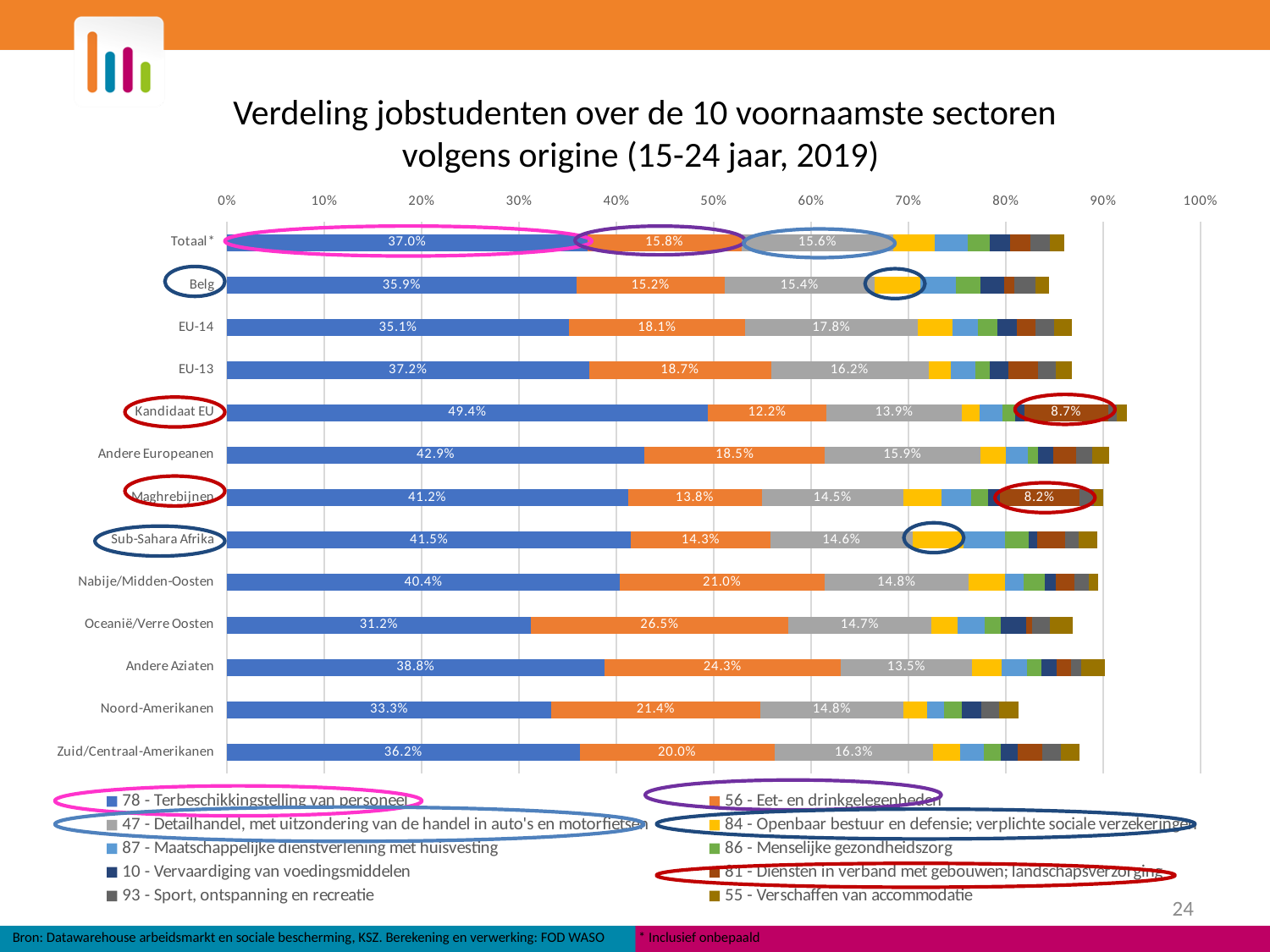
Which origin group has the highest share for '78 - Terbeschikkingstelling van personeel'? Kandidaat EU Which origin group has the highest share for '56 - Eet- en drinkgelegenheden'? Oceanië/Verre Oosten How many sectors (series) does the legend list? 10 Which has a larger share for '47 - Detailhandel, met uitzondering van de handel in auto's en motorfietsen': EU-14 or EU-13? EU-14 What is the value for '81 - Diensten in verband met gebouwen; landschapsverzorging' for Kandidaat EU? 8.7% Which origin group has the lowest share for '78 - Terbeschikkingstelling van personeel'? Oceanië/Verre Oosten What is the value for '56 - Eet- en drinkgelegenheden' in the Belg bar? 15.2% How many percentage points higher is the '78 - Terbeschikkingstelling van personeel' share for Kandidaat EU than for Totaal*? 12.4 percentage points What percentage of the Totaal* bar is for '78 - Terbeschikkingstelling van personeel'? 37.0% How many origin groups (bars) are shown in the chart? 13 What is the value for '47 - Detailhandel, met uitzondering van de handel in auto's en motorfietsen' for Noord-Amerikanen? 14.8% What type of chart is shown on the slide? Stacked bar chart